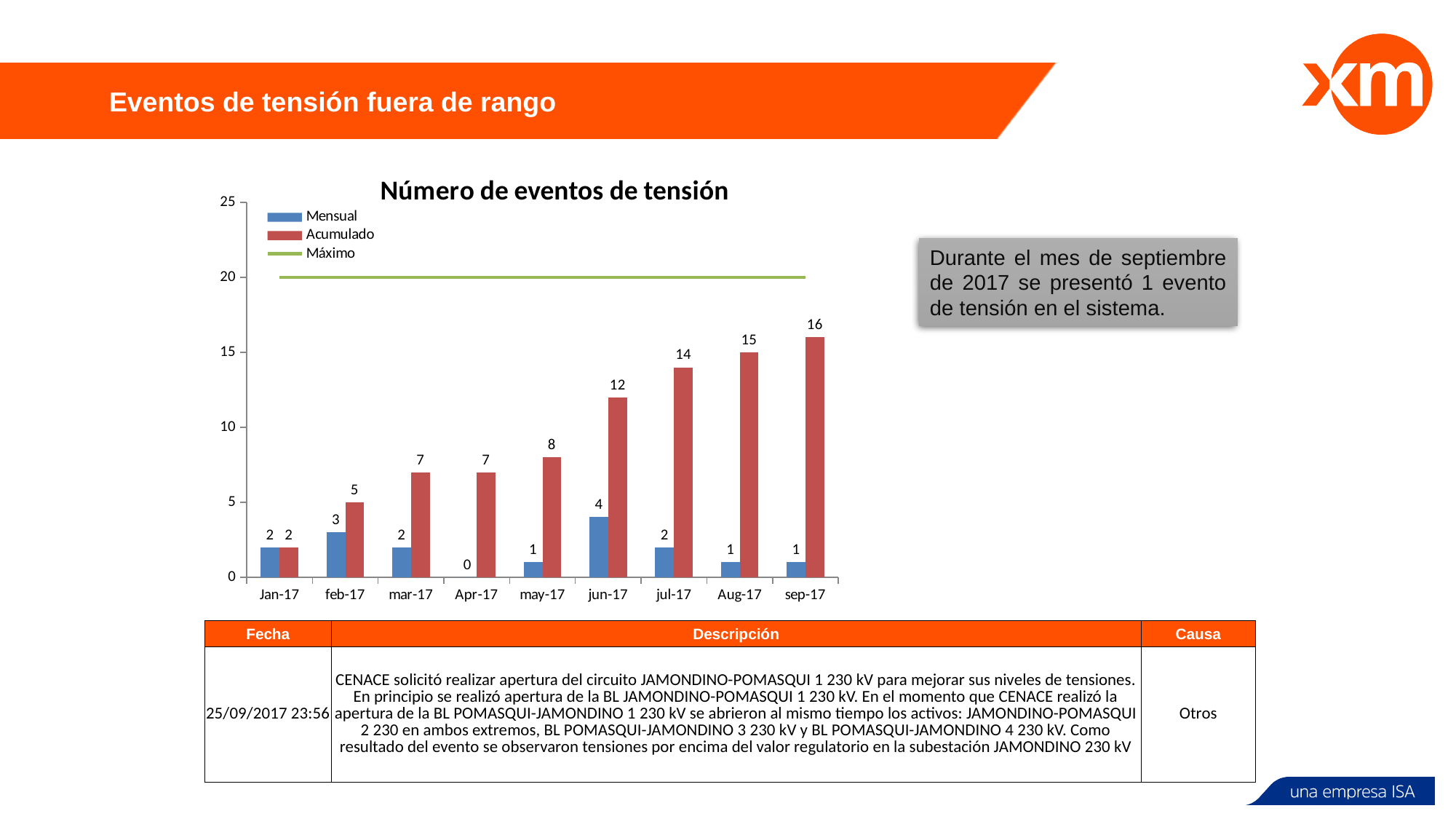
Is the Máximo line greater or less than 15? greater Which month has the highest Mensual value? jun-17 What is the difference between the Acumulado values for sep-17 and Jan-17? 14 What is the Mensual value for Apr-17? 0 Which is larger, the Mensual value for feb-17 or the Mensual value for mar-17? feb-17 Does the Acumulado series rise or fall from Jan-17 to sep-17? rise What is the Mensual value for jun-17? 4 What kind of chart is shown? bar chart How many months are shown on the x axis? 9 What is the Acumulado value for sep-17? 16 Which month has the lowest Mensual value? Apr-17 How many series does the legend list? 3